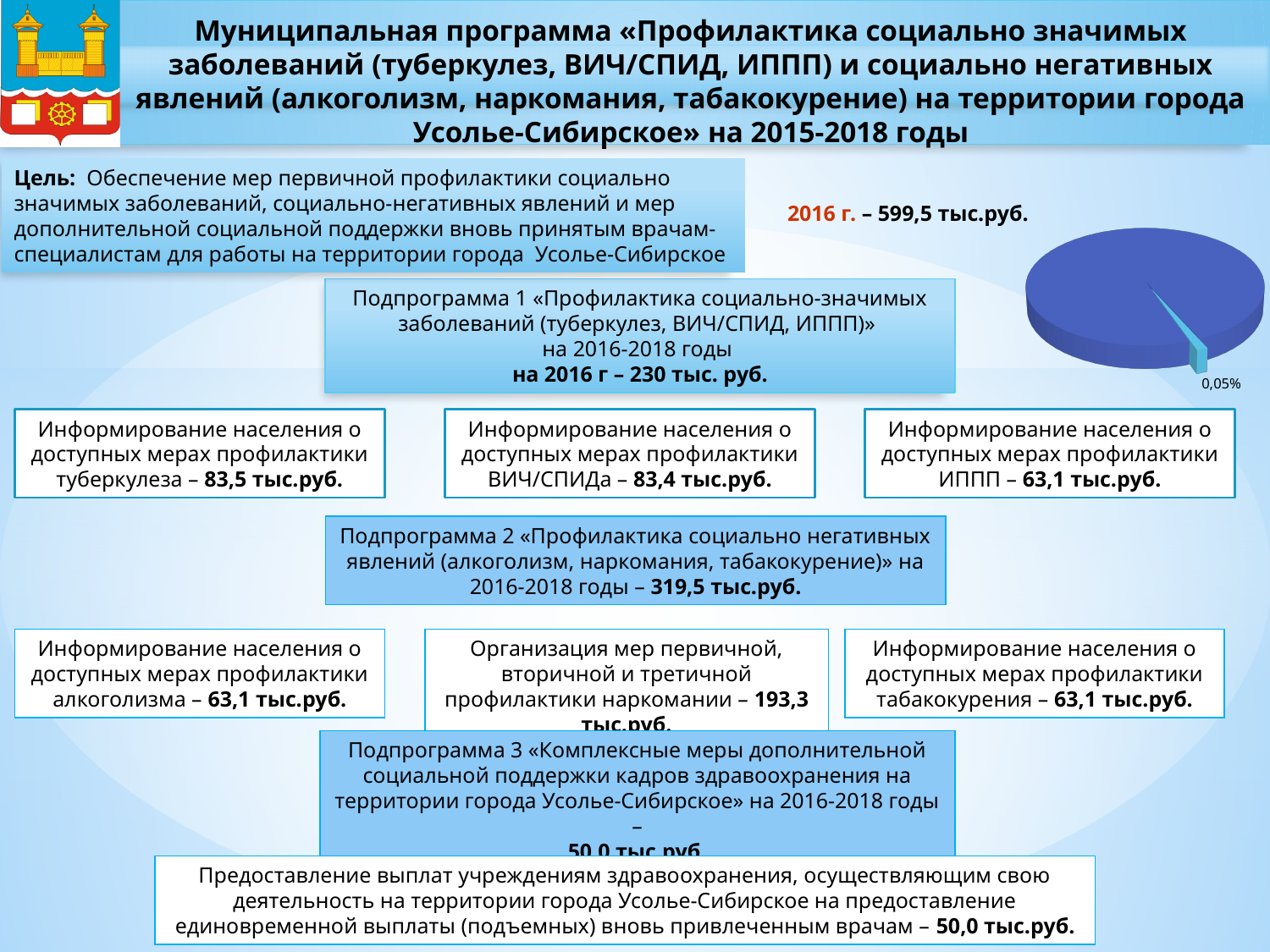
What kind of chart is shown on the right side of the slide? pie chart How many slices are visible in the pie chart? 2 Is the share of the slice labelled 0,05% greater or less than 50%? less Is the slice labelled 0,05% the largest or the smallest slice of the pie chart? smallest What share of the pie does the small sliver slice represent, according to its label? 0,05% What colour is the large slice of the pie chart? blue What is the only data label printed on the pie chart? 0,05% Does the pie chart have a legend? No